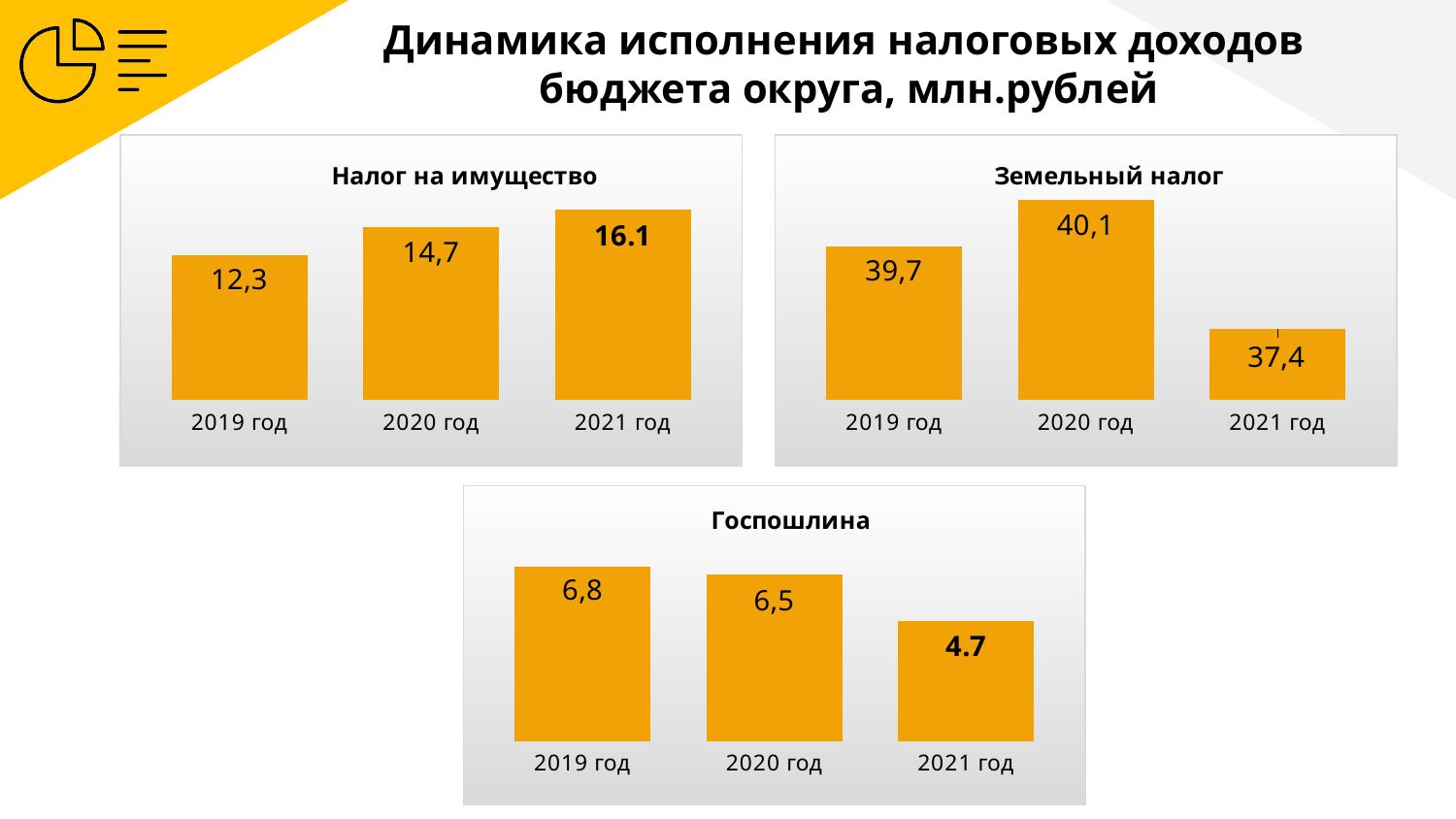
In the 'Земельный налог' chart, what is the value for 2020 год? 40,1 What type of chart is the 'Земельный налог' chart? bar chart How many bars are in the 'Госпошлина' chart? 3 In the 'Земельный налог' chart, what is the difference between the values for 2020 год and 2019 год? 0,4 In the 'Госпошлина' chart, what is the value for 2021 год? 4.7 In the 'Госпошлина' chart, which year has the highest value? 2019 год In the 'Госпошлина' chart, do the values rise or fall from 2019 год to 2021 год? fall In the 'Земельный налог' chart, which year has the lowest value? 2021 год In the 'Налог на имущество' chart, which year has the highest value? 2021 год In the 'Налог на имущество' chart, what is the value for 2019 год? 12,3 In the 'Налог на имущество' chart, what is the value for 2021 год? 16.1 In the 'Налог на имущество' chart, what is the difference between the values for 2020 год and 2019 год? 2,4